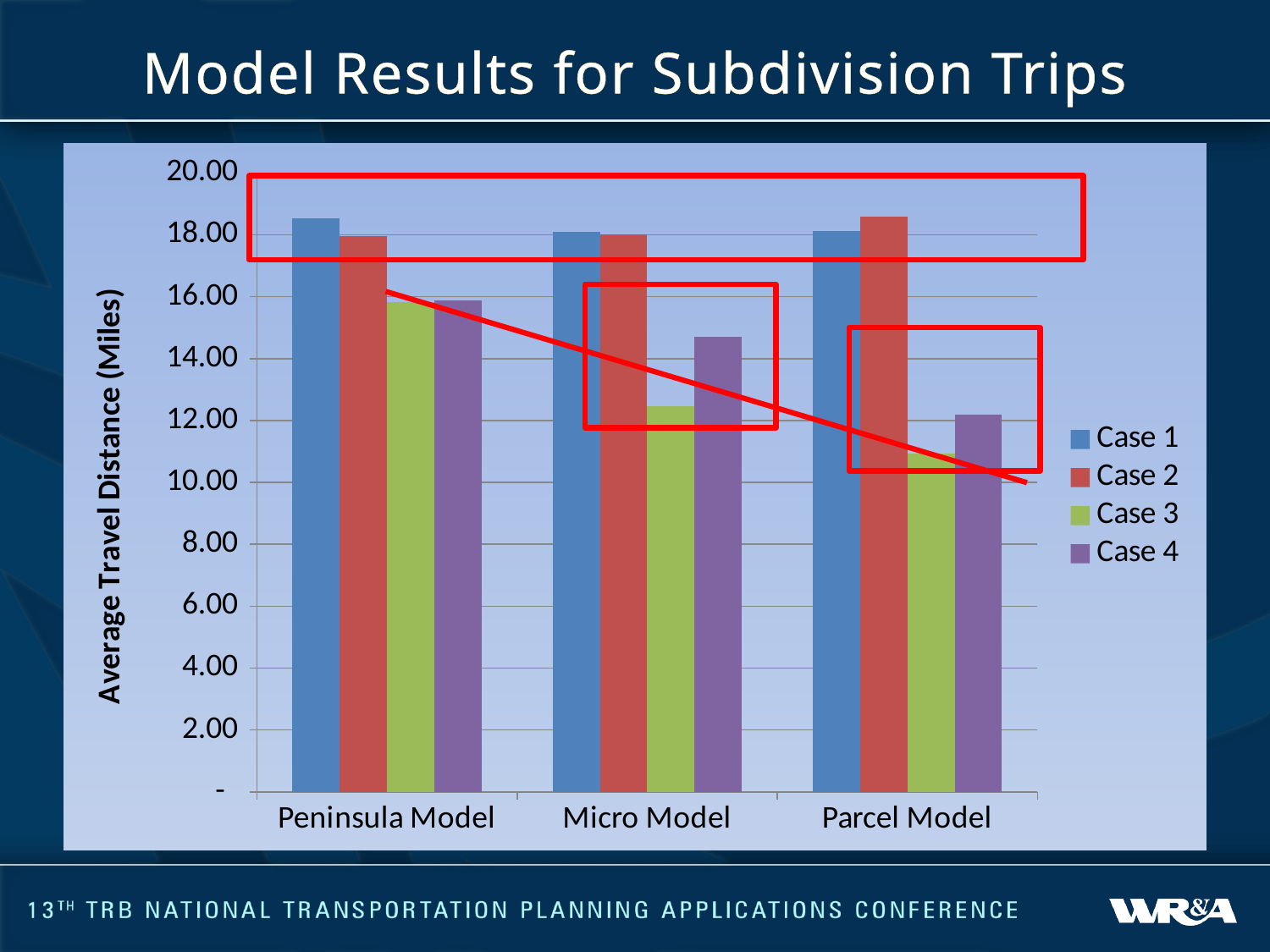
Which case has the lowest value for the Parcel Model? Case 3 How many model categories are shown on the x axis? 3 Do the Case 3 values rise or fall from the Peninsula Model to the Parcel Model? fall What kind of chart is shown on the slide? bar chart Is the Case 4 value for the Micro Model greater or less than 14.00? greater Is the Case 3 value for the Micro Model greater or less than 14.00? less For the Micro Model, which is larger, Case 3 or Case 4? Case 4 Is the Case 3 value for the Parcel Model greater or less than 12.00? less What is the title of the vertical axis? Average Travel Distance (Miles) Which model has the lowest Case 3 value? Parcel Model How many series does the legend list? 4